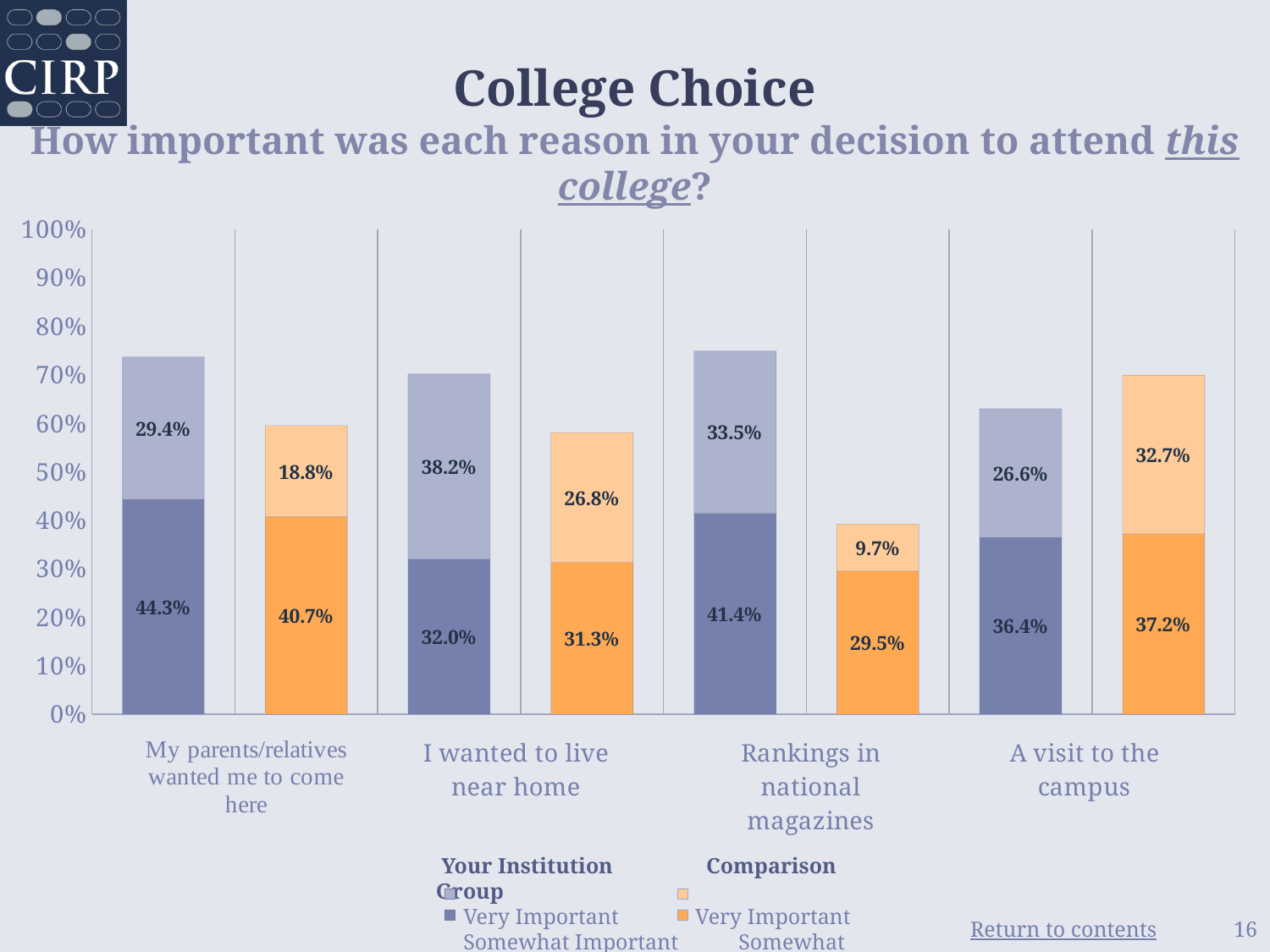
Which reason has the highest Very Important percentage for Your Institution? My parents/relatives wanted me to come here How many series does the chart legend list? 4 What type of chart is shown on the slide? Stacked bar chart What percentage of the Comparison Group rated "Rankings in national magazines" as Somewhat Important? 9.7% How many reasons (categories) are shown on the x axis of the chart? 4 What is the total stacked percentage (Very Important plus Somewhat Important) for the Comparison Group bar for "My parents/relatives wanted me to come here"? 59.5% For "A visit to the campus", which group has the larger Very Important percentage, Your Institution or the Comparison Group? Comparison Group Which reason has the lowest Somewhat Important percentage for the Comparison Group? Rankings in national magazines What is the difference between the Your Institution and Comparison Group Very Important percentages for "Rankings in national magazines"? 11.9% What percentage of Your Institution students rated "My parents/relatives wanted me to come here" as Very Important? 44.3% What percentage of Your Institution students rated "A visit to the campus" as Somewhat Important? 26.6% What is the total stacked percentage for the Your Institution bar for "I wanted to live near home"? 70.2%